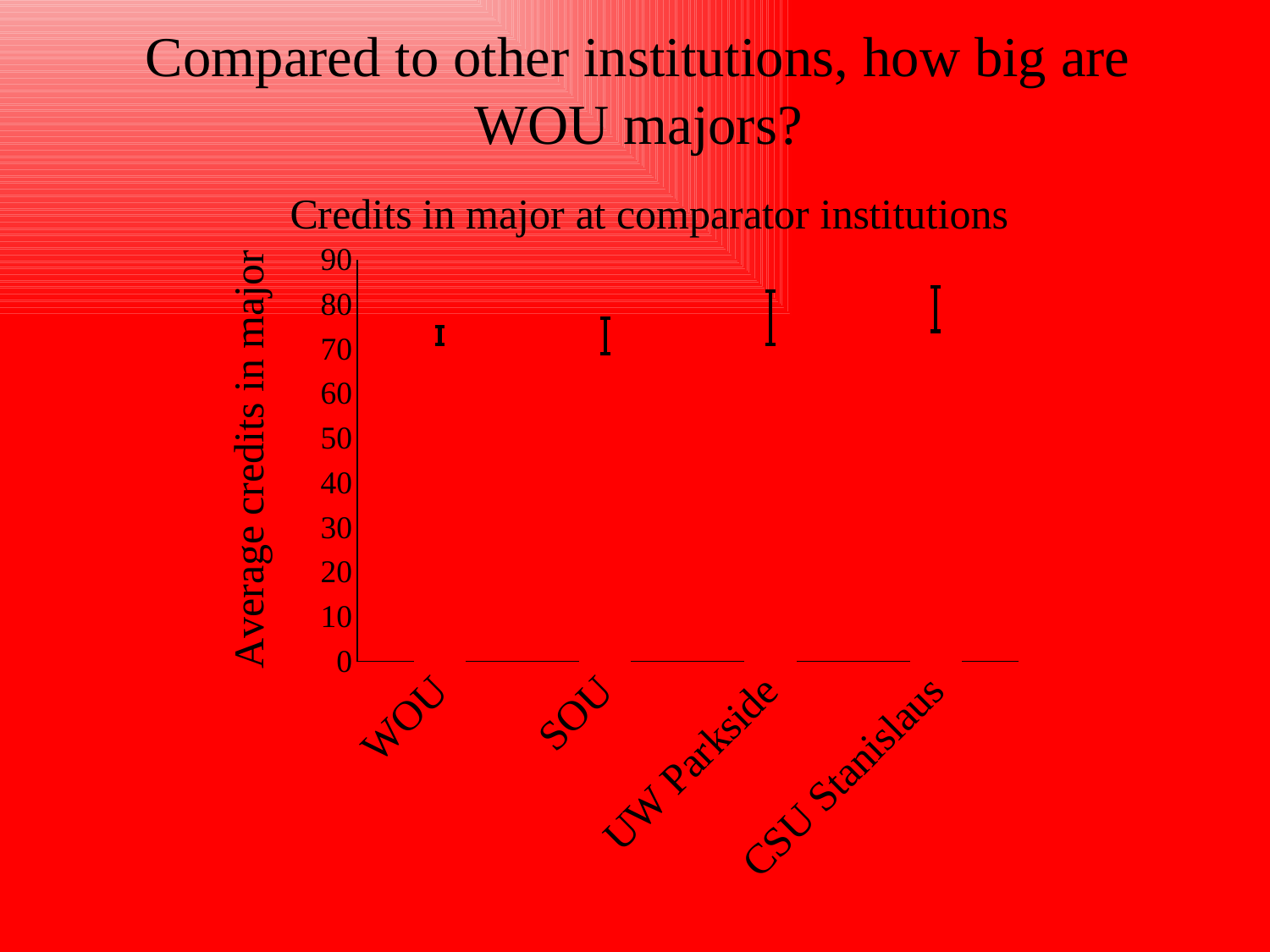
Is the value for UW Parkside greater or less than 90? less Is the value for SOU greater or less than 50? greater Is the value for SOU greater or less than 60? greater What is the title of the chart? Credits in major at comparator institutions How many institutions are shown on the x axis of the chart? 4 What is the label on the vertical axis of the chart? Average credits in major